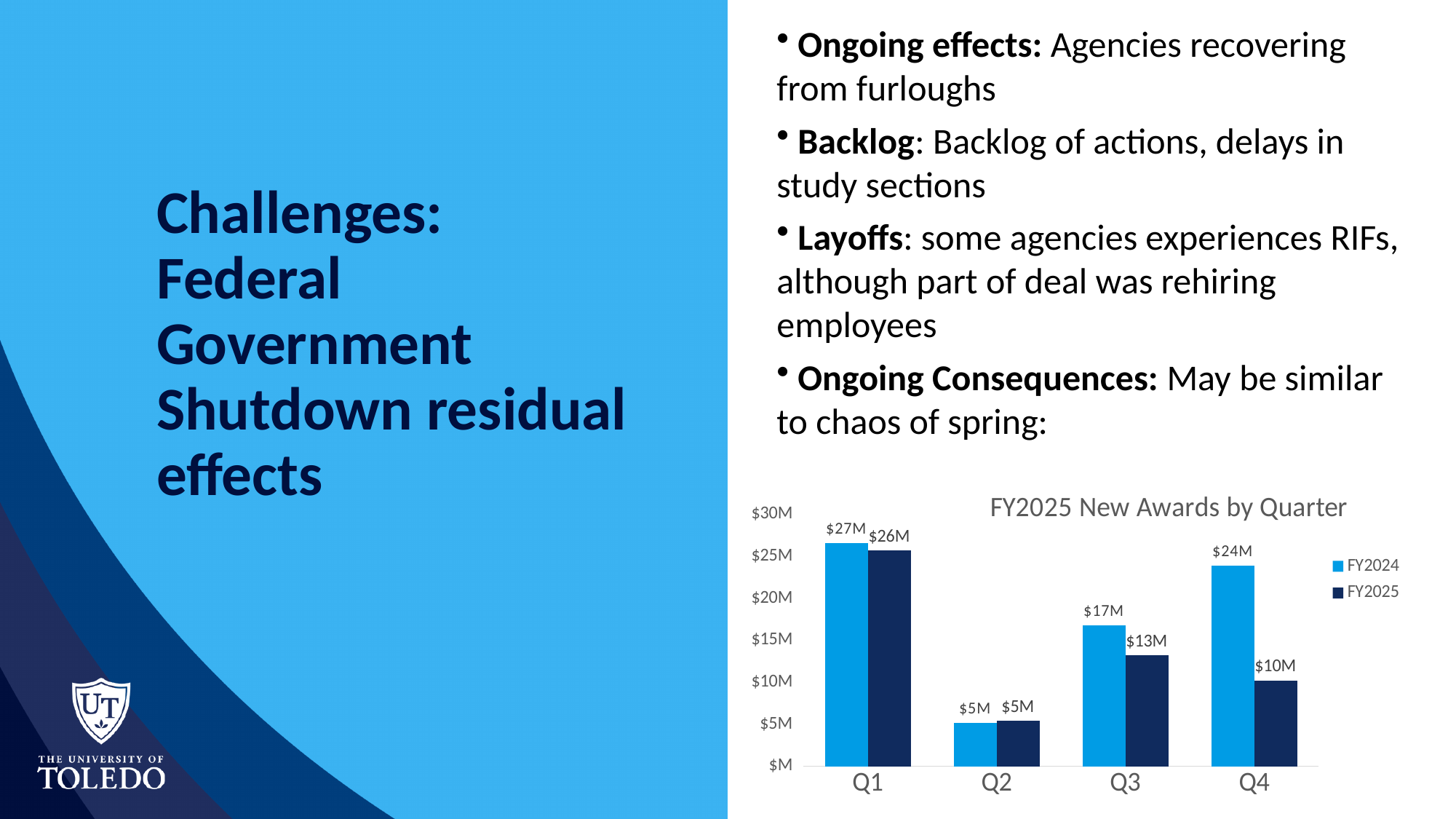
How many series does the legend list? 2 Which quarter has the highest FY2024 value? Q1 What is the FY2024 value for Q1? $27M What is the FY2025 value for Q4? $10M Which is larger in Q3, the FY2024 value or the FY2025 value? FY2024 Is the FY2024 value for Q4 greater or less than $20M? greater What is the difference between the FY2024 and FY2025 values for Q4? $14M What is the title of the chart? FY2025 New Awards by Quarter Which quarter has the lowest FY2025 value? Q2 What kind of chart is shown on the slide? Bar chart What is the FY2025 value for Q3? $13M How many quarters are shown on the x axis? 4